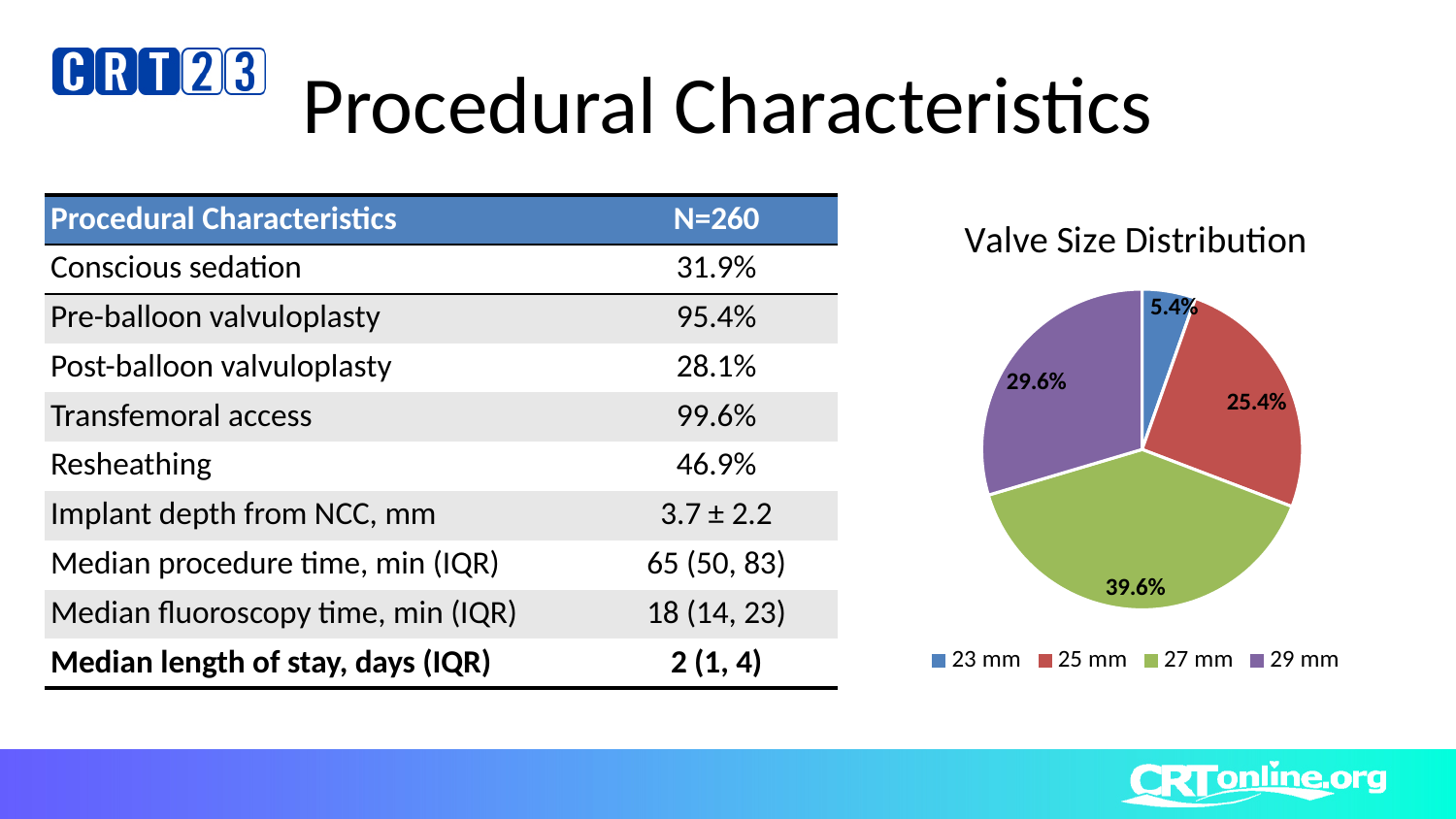
What share of the pie does the 23 mm valve size represent? 5.4% What colour is the 27 mm slice in the pie chart? green What is the difference in percentage points between the 27 mm and 25 mm slices? 14.2 What is the difference in percentage points between the 29 mm and 23 mm slices? 24.2 What share of the pie does the 27 mm valve size represent? 39.6% What is the value shown for the 29 mm slice? 29.6% Which valve size has the smallest share of the pie? 23 mm What is the value shown for the 25 mm slice? 25.4% Which valve size has the largest share of the pie? 27 mm How many valve sizes are shown in the pie chart? 4 Which slice is larger, 29 mm or 25 mm? 29 mm What type of chart is shown under the title "Valve Size Distribution"? pie chart